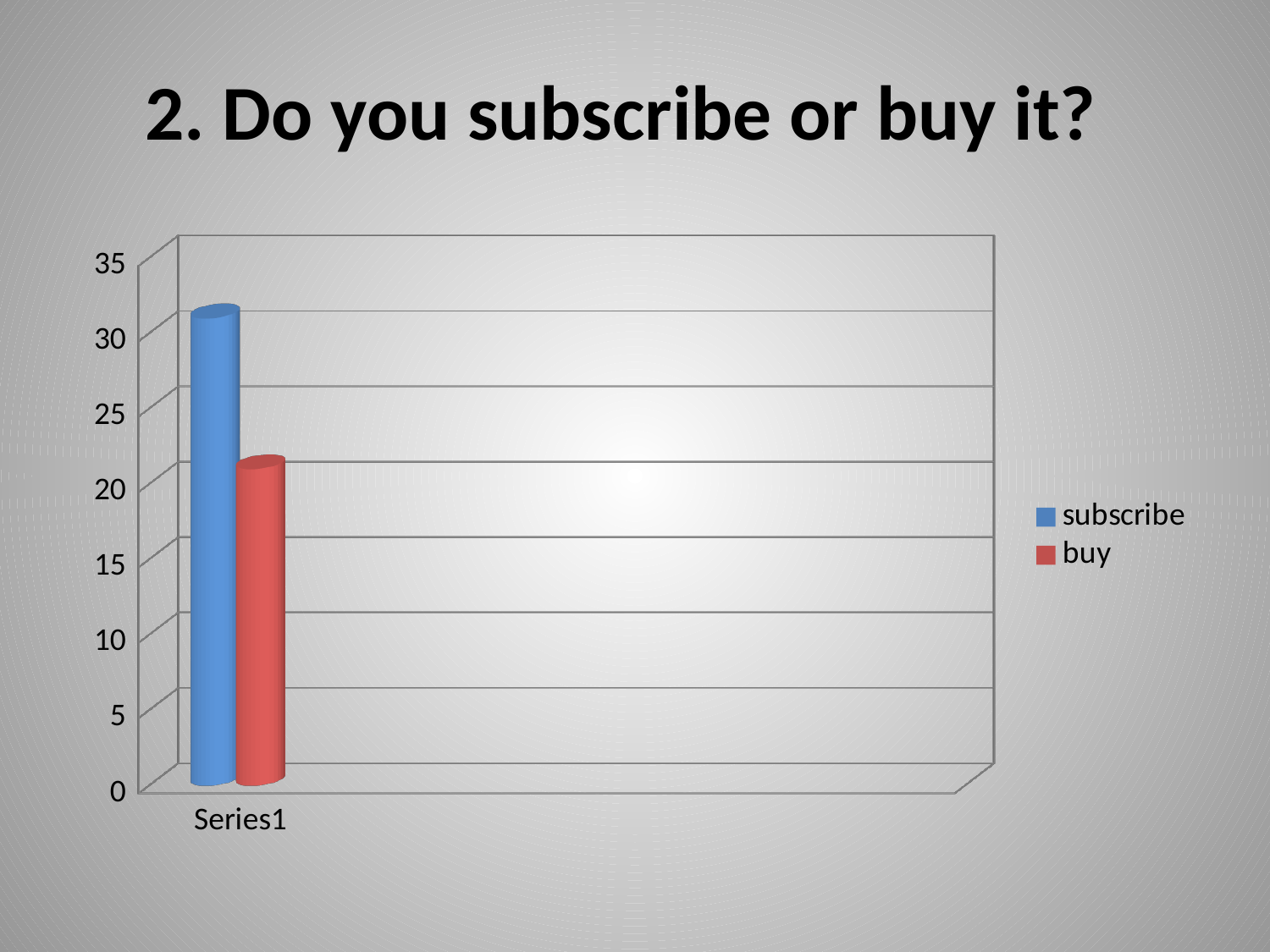
Which series has the highest value? subscribe Which is larger, the value for subscribe or the value for buy? subscribe How many series does the legend list? 2 Which series has the lowest value? buy Is the value for buy greater or less than 15? greater What colour is the bar for the buy series? red What is the title of the slide containing the chart? 2. Do you subscribe or buy it? How many categories are shown on the x axis? 1 What kind of chart is shown on the slide? bar chart Is the value for buy greater or less than 25? less Is the value for subscribe greater or less than 25? greater